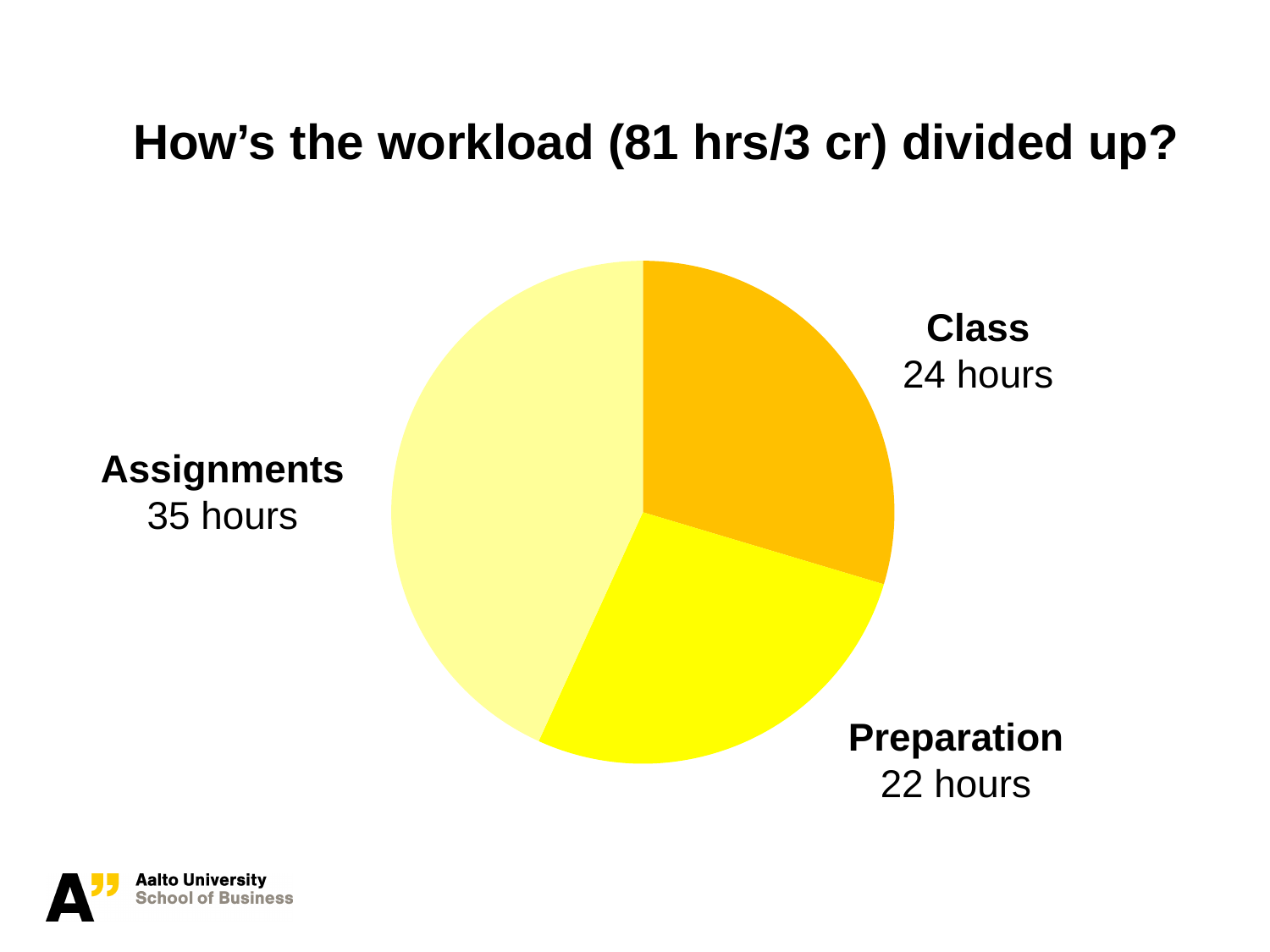
How many more hours are spent on Assignments than on Class? 11 hours How many hours are shown for Preparation? 22 hours How many categories does the pie chart show? 3 How many hours are allocated to Assignments in the pie chart? 35 hours How many hours does the Class slice represent? 24 hours What is the difference in hours between Class and Preparation? 2 hours What is the total number of hours across all three slices of the pie chart? 81 hours What type of chart is shown on the slide? Pie chart Which category takes the largest share of the workload? Assignments Which category takes the smallest share of the workload? Preparation Which is larger, the hours for Class or the hours for Preparation? Class What is the title of the slide containing the pie chart? How's the workload (81 hrs/3 cr) divided up?